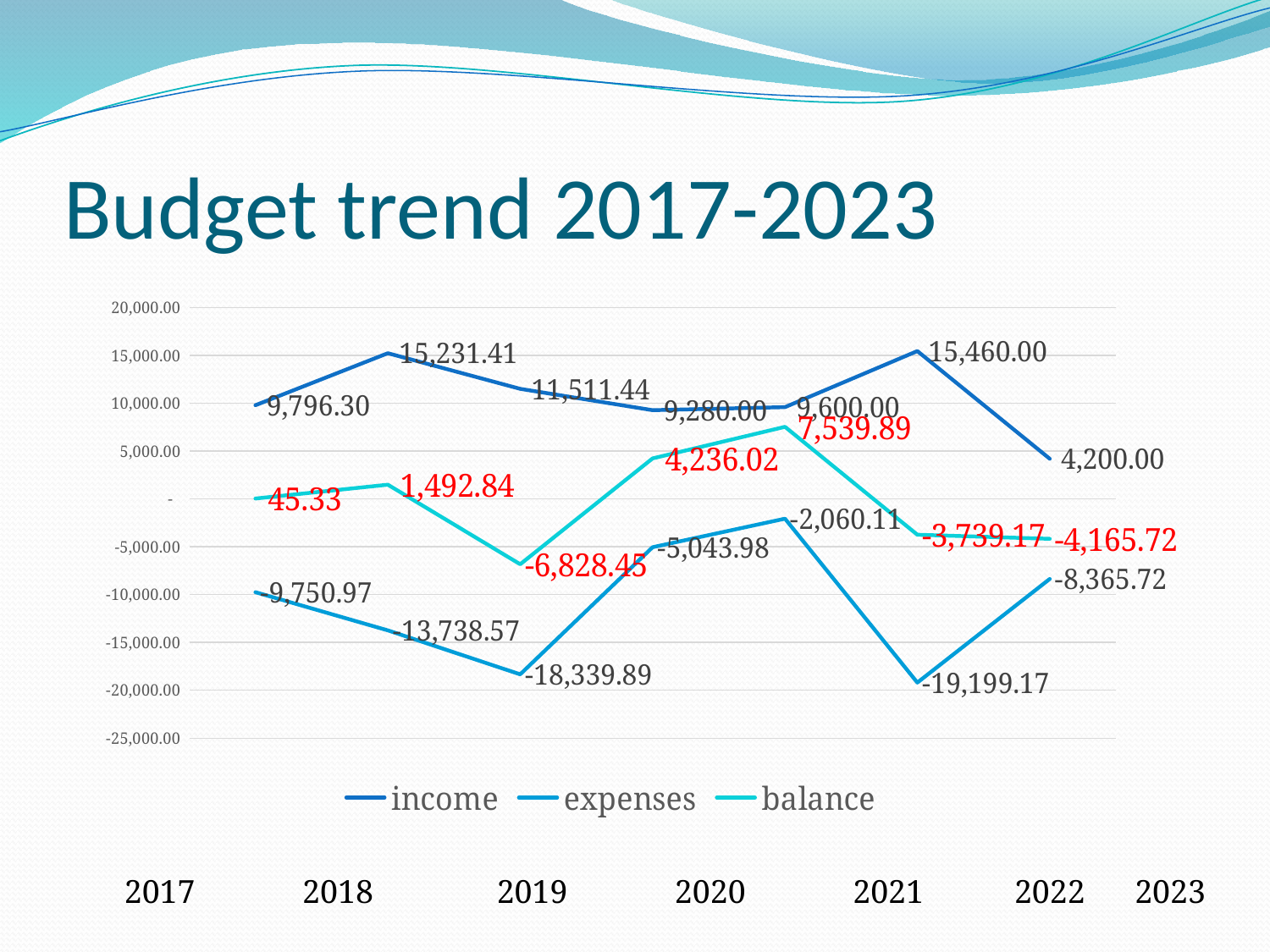
How many data points does the income series have? 7 What is the last (rightmost) value of the expenses series? -8,365.72 What is the difference between the two highest income values, 15,460.00 and 15,231.41? 228.59 What is the highest value in the income series? 15,460.00 What is the highest value in the balance series? 7,539.89 What type of chart is shown on the slide? line chart How many series does the legend list? 3 What is the lowest value in the balance series? -6,828.45 What are the three series names listed in the legend? income, expenses, balance What is the lowest value in the expenses series? -19,199.17 Which is larger: the balance value 4,236.02 or the balance value 1,492.84? 4,236.02 What is the first (leftmost) value of the income series? 9,796.30